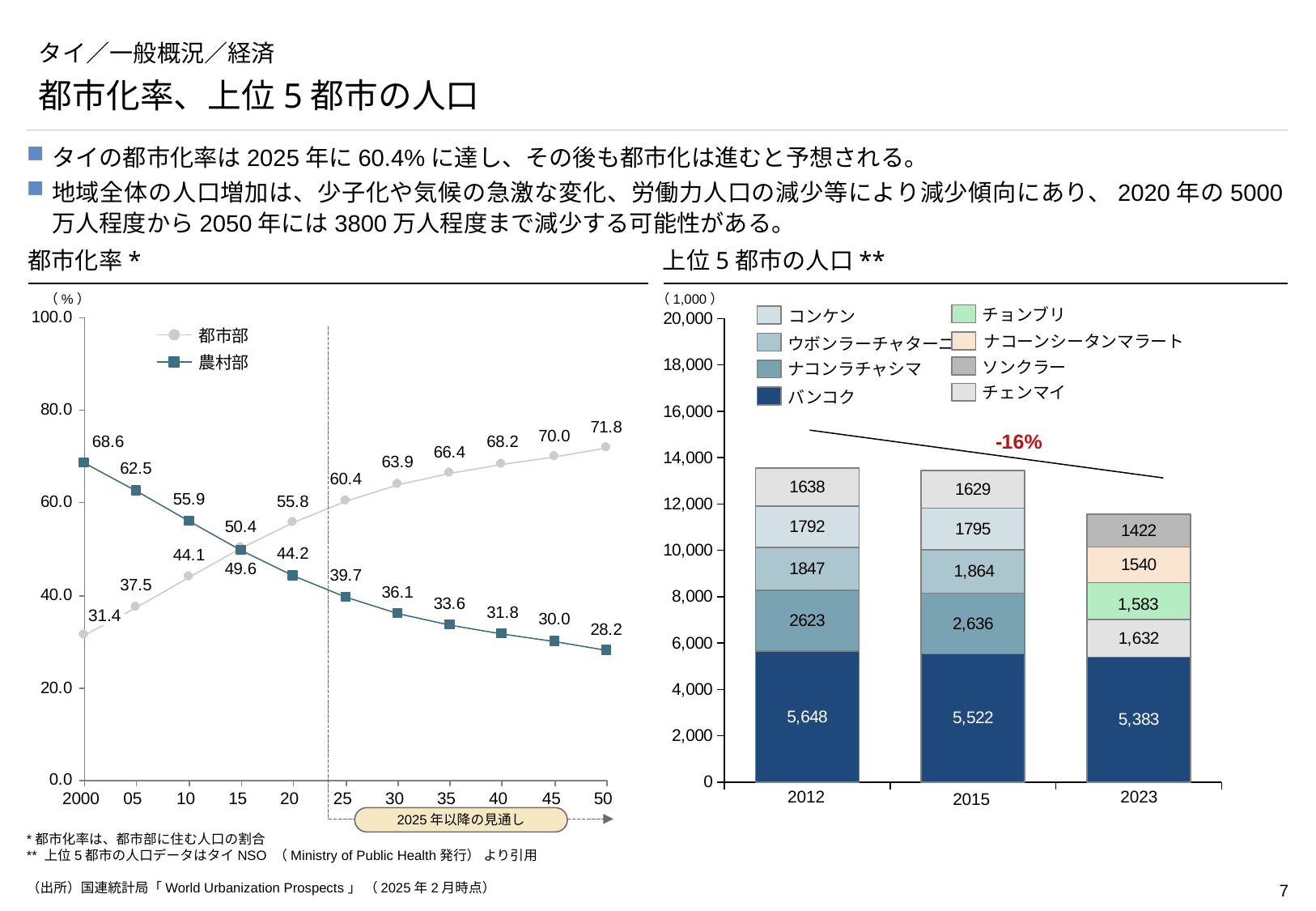
In the 都市化率 chart on the left, what is the 都市部 value for 2025? 60.4 What kind of chart is the 都市化率 chart on the left? line chart In the 上位5都市の人口 chart on the right, which year has the lowest total bar? 2023 In the 上位5都市の人口 chart on the right, what is the バンコク value for 2023? 5,383 In the 都市化率 chart on the left, what is the difference between the 都市部 and 農村部 values in 2050? 43.6 In the 上位5都市の人口 chart on the right, what is the total of the stacked bar for 2012? 13,548 In the 都市化率 chart on the left, does the 農村部 series rise or fall from 2000 to 2050? fall In the 上位5都市の人口 chart on the right, what percentage change is annotated above the bars? -16% In the 都市化率 chart on the left, what is the 農村部 value for 2000? 68.6 In the 都市化率 chart on the left, how many series does the legend list? 2 In the 上位5都市の人口 chart on the right, how many entries does the legend list? 8 In the 都市化率 chart on the left, which series has the higher value in 2010, 都市部 or 農村部? 農村部